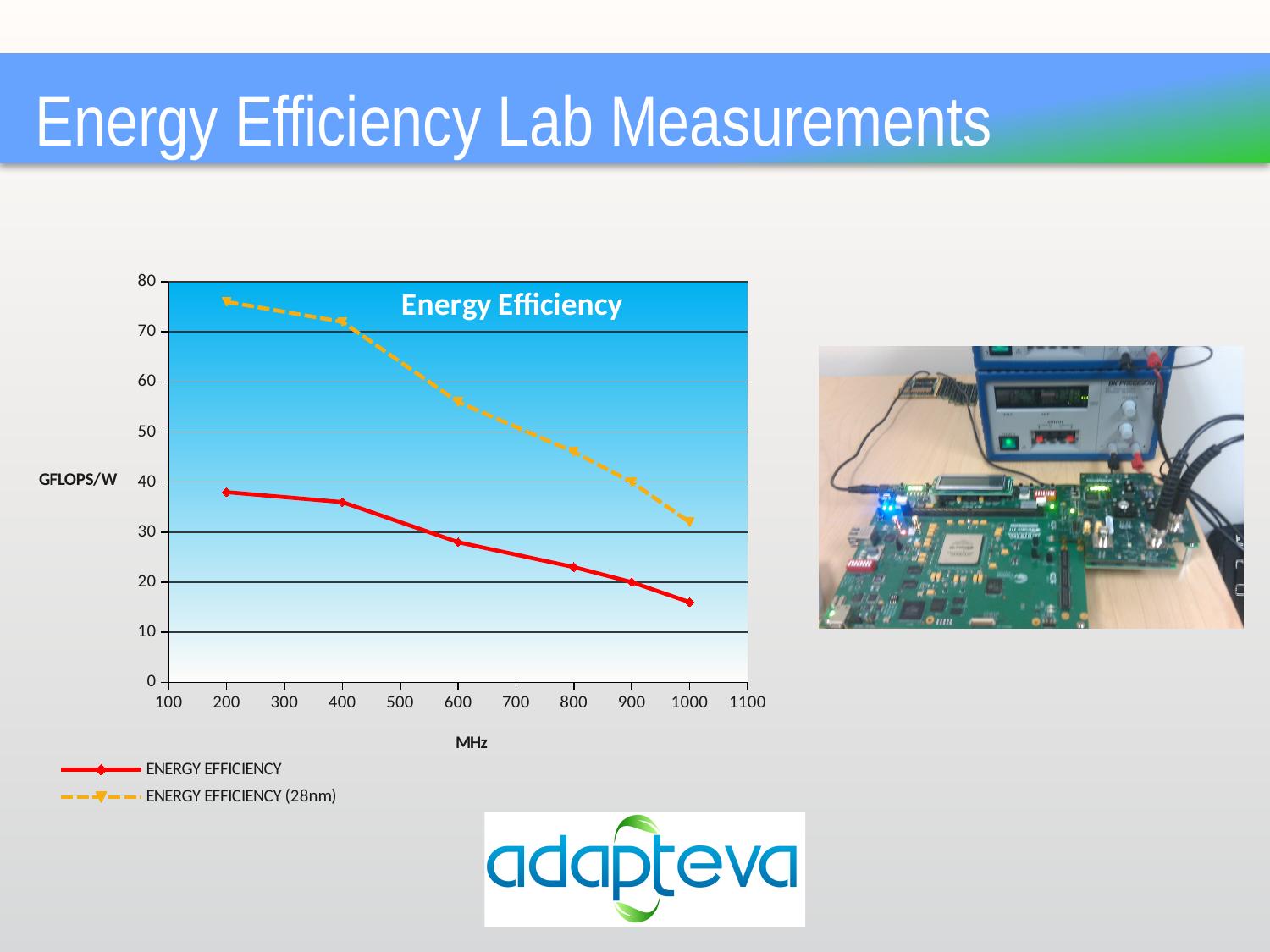
Is the ENERGY EFFICIENCY (28nm) value at 200 MHz greater or less than 70? greater At which MHz value is the ENERGY EFFICIENCY series highest? 200 Is the ENERGY EFFICIENCY (28nm) value at 1000 MHz greater or less than 40? less Do the ENERGY EFFICIENCY (28nm) values rise or fall as MHz increases? fall Which series has the higher value at 600 MHz, ENERGY EFFICIENCY or ENERGY EFFICIENCY (28nm)? ENERGY EFFICIENCY (28nm) Is the ENERGY EFFICIENCY value at 1000 MHz greater or less than 20? less How many series does the chart legend list? 2 What kind of chart is shown on the slide? line chart What is the label on the vertical axis of the chart? GFLOPS/W How many data points are plotted for the ENERGY EFFICIENCY series? 6 Do the ENERGY EFFICIENCY values rise or fall as MHz increases? fall